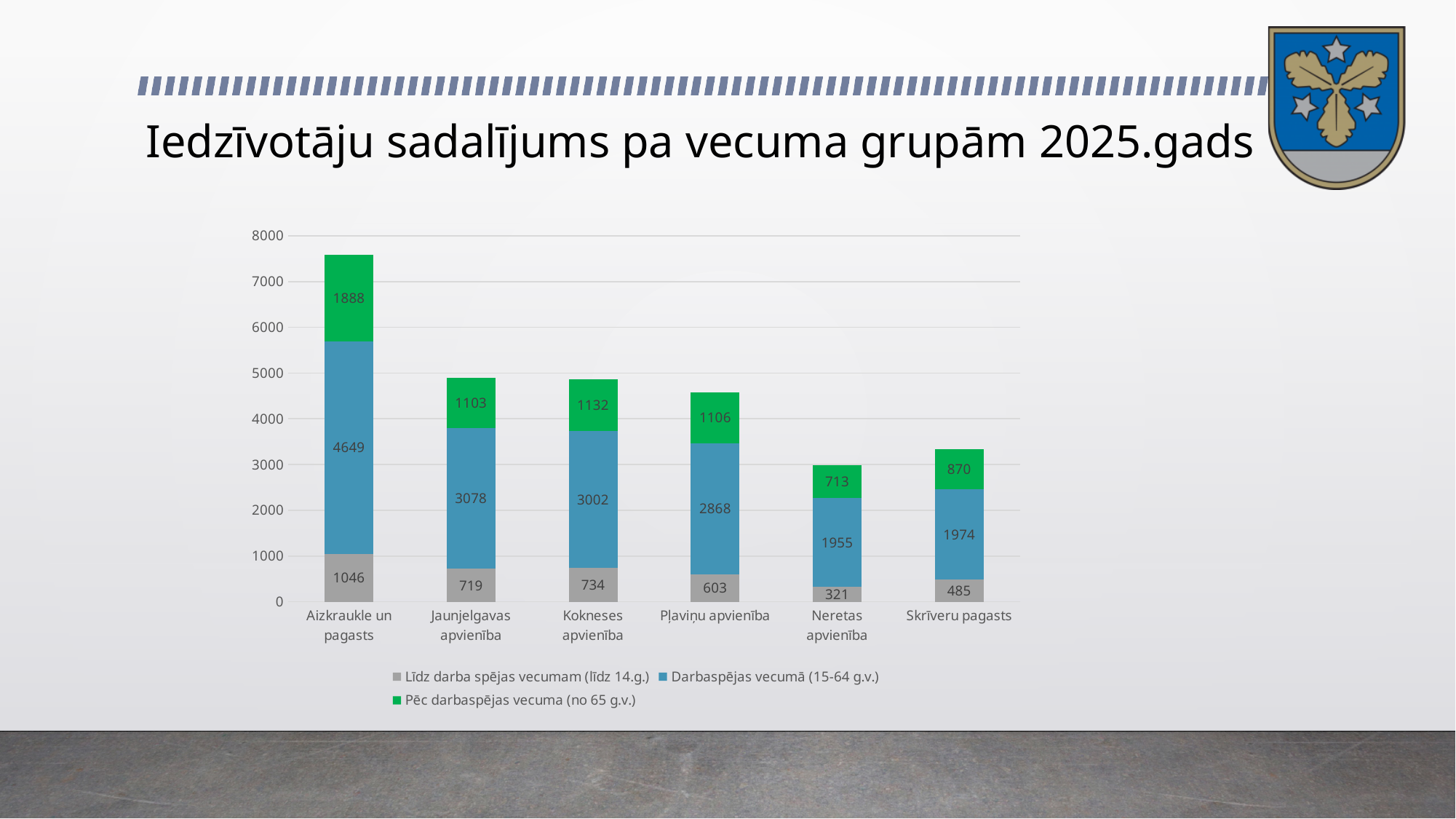
Which category has the highest value for Darbaspējas vecumā (15-64 g.v.)? Aizkraukle un pagasts What is the total of the stacked bar for Neretas apvienība? 2989 What is the value for Līdz darba spējas vecumam (līdz 14.g.) in Neretas apvienība? 321 What kind of chart is shown on the slide? Stacked bar chart How many categories are shown on the x axis? 6 What is the total of the stacked bar for Aizkraukle un pagasts? 7583 What is the difference between the Darbaspējas vecumā (15-64 g.v.) values for Jaunjelgavas apvienība and Kokneses apvienība? 76 What is the value for Pēc darbaspējas vecuma (no 65 g.v.) in Kokneses apvienība? 1132 Which category has the lowest value for Pēc darbaspējas vecuma (no 65 g.v.)? Neretas apvienība Which is larger: the Līdz darba spējas vecumam (līdz 14.g.) value for Pļaviņu apvienība or for Skrīveru pagasts? Pļaviņu apvienība What is the value for Darbaspējas vecumā (15-64 g.v.) in Aizkraukle un pagasts? 4649 How many series does the legend list? 3